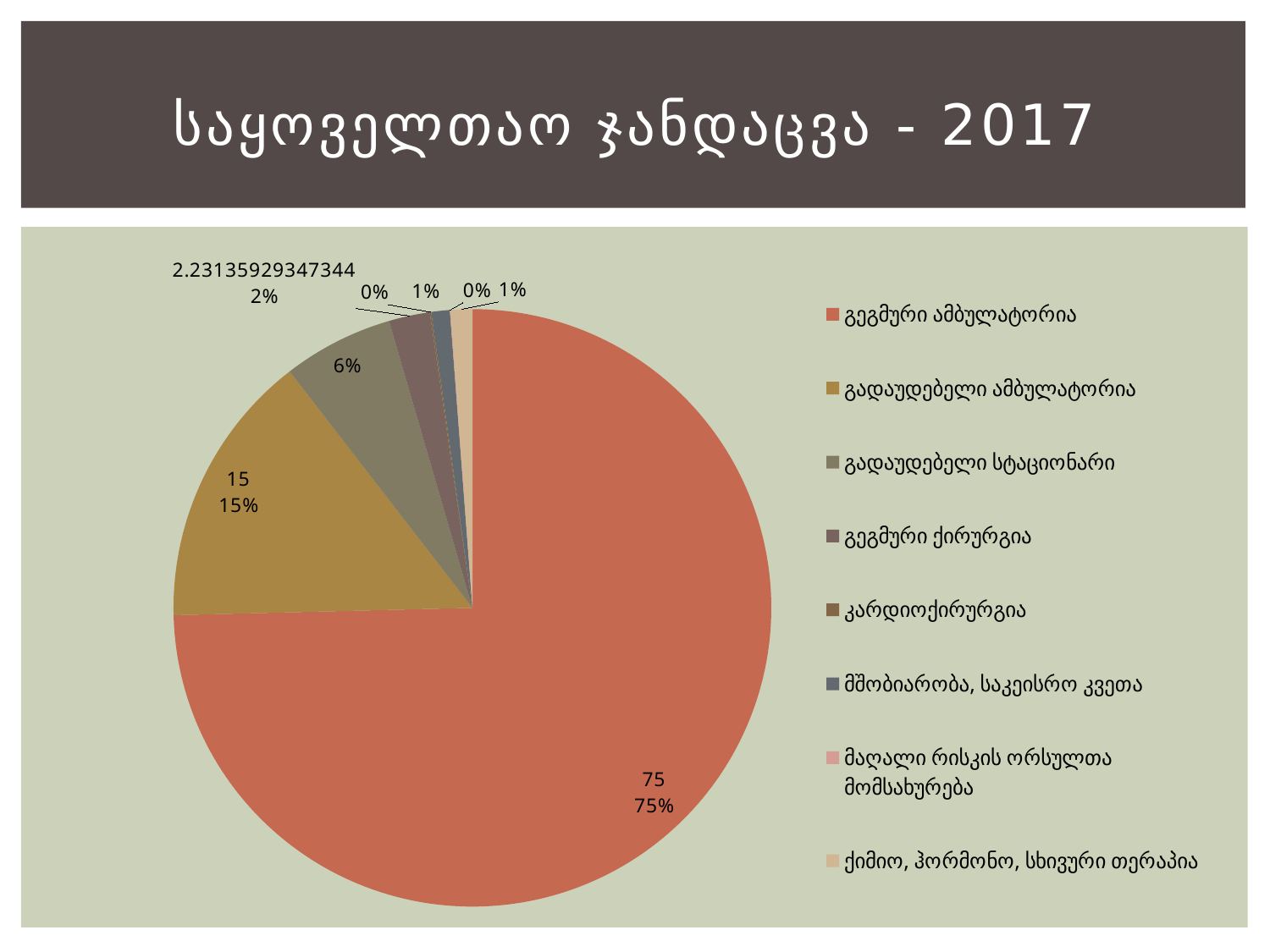
What percentage share does გეგმური ამბულატორია have in the pie? 75% What value is printed for the გადაუდებელი ამბულატორია slice? 15 What percentage share does გადაუდებელი ამბულატორია have in the pie? 15% Which category has the largest slice of the pie? გეგმური ამბულატორია What percentage share does გადაუდებელი სტაციონარი have in the pie? 6% What colour is the slice for გეგმური ამბულატორია? red Which is larger, the slice for გადაუდებელი ამბულატორია or the slice for გადაუდებელი სტაციონარი? გადაუდებელი ამბულატორია What is the title of the chart on the slide? საყოველთაო ჯანდაცვა - 2017 What value is printed for the გეგმური ამბულატორია slice? 75 What kind of chart is shown on the slide? pie chart How many entries does the legend list? 8 What is the difference between the values printed for გეგმური ამბულატორია and გადაუდებელი ამბულატორია? 60